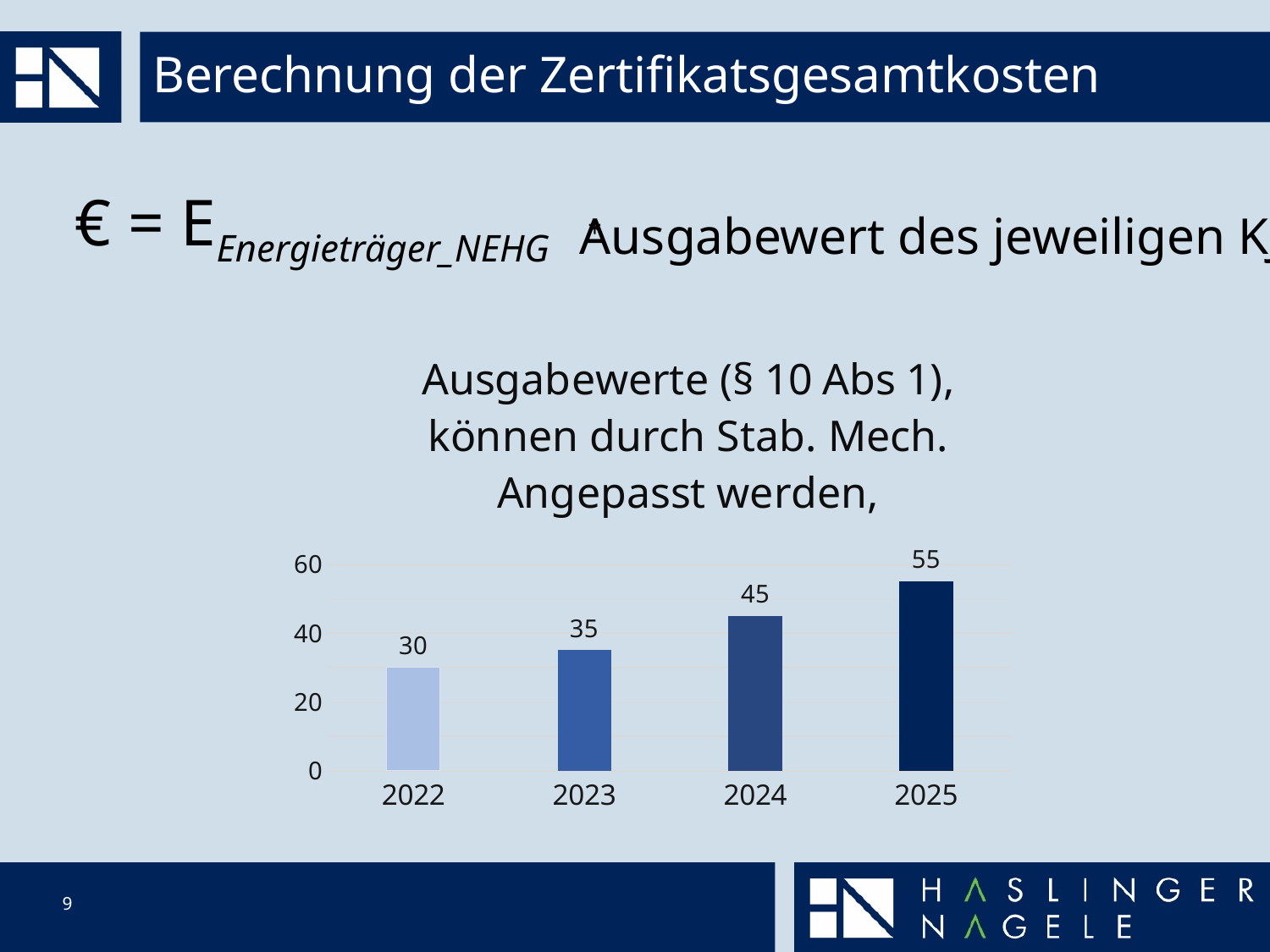
Which is larger, the value for 2023 or the value for 2024? 2024 How many years are shown on the x axis? 4 What kind of chart is shown? bar chart Which year has the highest value? 2025 Do the values rise or fall from 2022 to 2025? rise What is the difference between the values for 2024 and 2023? 10 What is the difference between the values for 2025 and 2022? 25 What is the value for 2023? 35 What is the value for 2025? 55 Which year has the lowest value? 2022 What is the value for 2024? 45 What is the value for 2022? 30